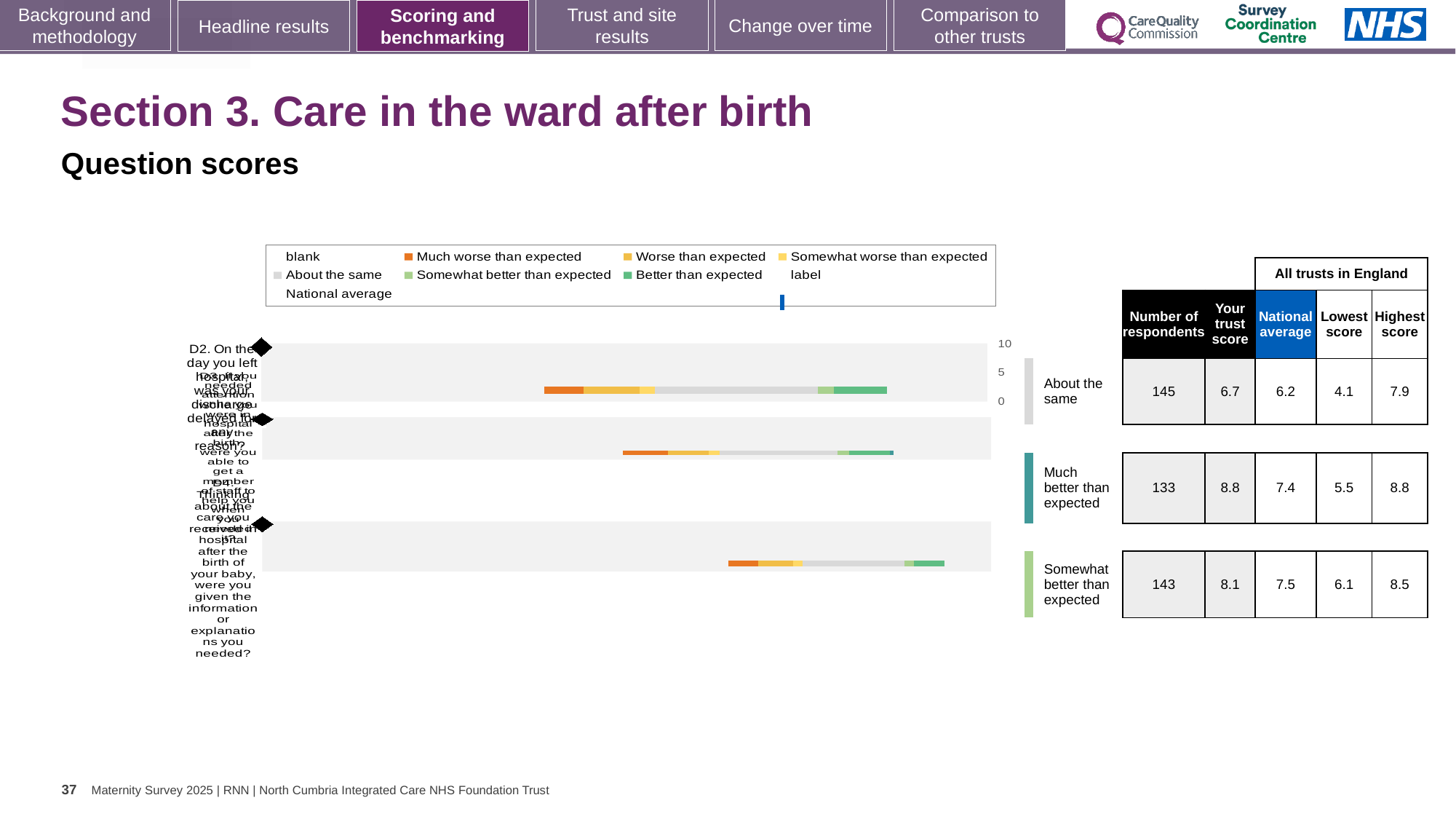
What kind of chart is shown on the slide? bar chart In the table beside the chart, what is the difference between the trust score and the national average for the row rated 'About the same'? 0.5 How many horizontal bars are plotted in the chart? 3 In the table beside the chart, what is the highest score for the row rated 'About the same'? 7.9 Which row in the table beside the chart has the highest trust score? Much better than expected Which row in the table beside the chart has the lowest number of respondents? Much better than expected In the table beside the chart, what is the number of respondents for the row rated 'About the same'? 145 In the table beside the chart, for the row rated 'Somewhat better than expected', which is larger: the trust score or the national average? the trust score What colour represents 'Much worse than expected' in the chart legend? orange In the table beside the chart, what is the national average for the row rated 'Somewhat better than expected'? 7.5 What colour represents 'Better than expected' in the chart legend? green In the table beside the chart, what is the trust score for the row rated 'Much better than expected'? 8.8